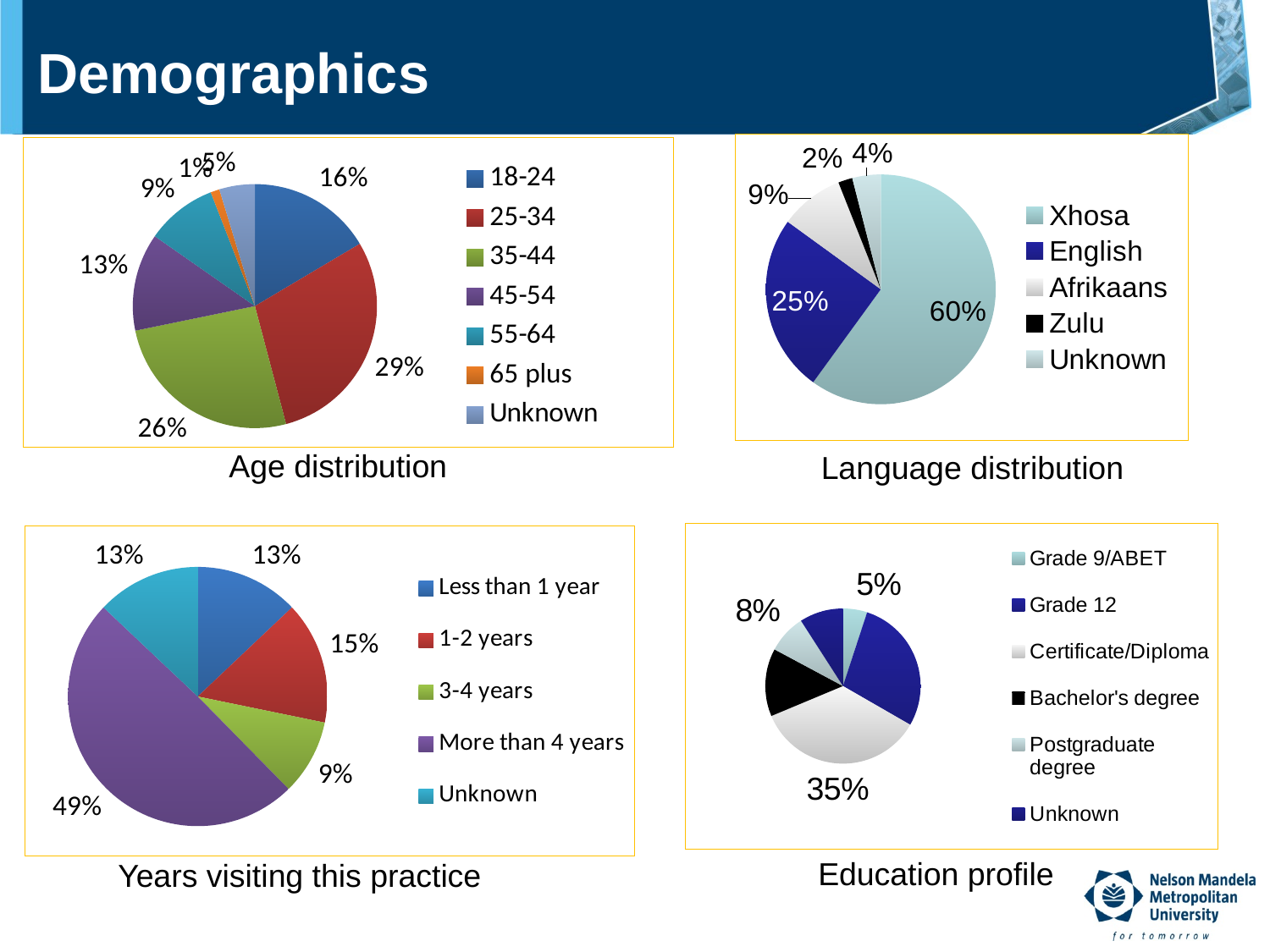
In the Age distribution chart, what percentage is the 25-34 group? 29% In the Age distribution chart, which age group has the largest share? 25-34 In the Years visiting this practice chart, which is larger: '1-2 years' or '3-4 years'? 1-2 years How many entries does the legend of the Age distribution chart list? 7 How many categories are shown in the Years visiting this practice chart? 5 In the Years visiting this practice chart, what percentage is 'More than 4 years'? 49% In the Language distribution chart, which language has the smallest share? Zulu In the Language distribution chart, what is the difference between the Xhosa and English shares? 35% What type of chart is the Language distribution chart? Pie chart In the Language distribution chart, what share is Xhosa? 60% In the Education profile chart, what percentage is Certificate/Diploma? 35% In the Age distribution chart, what percentage is the 35-44 group? 26%